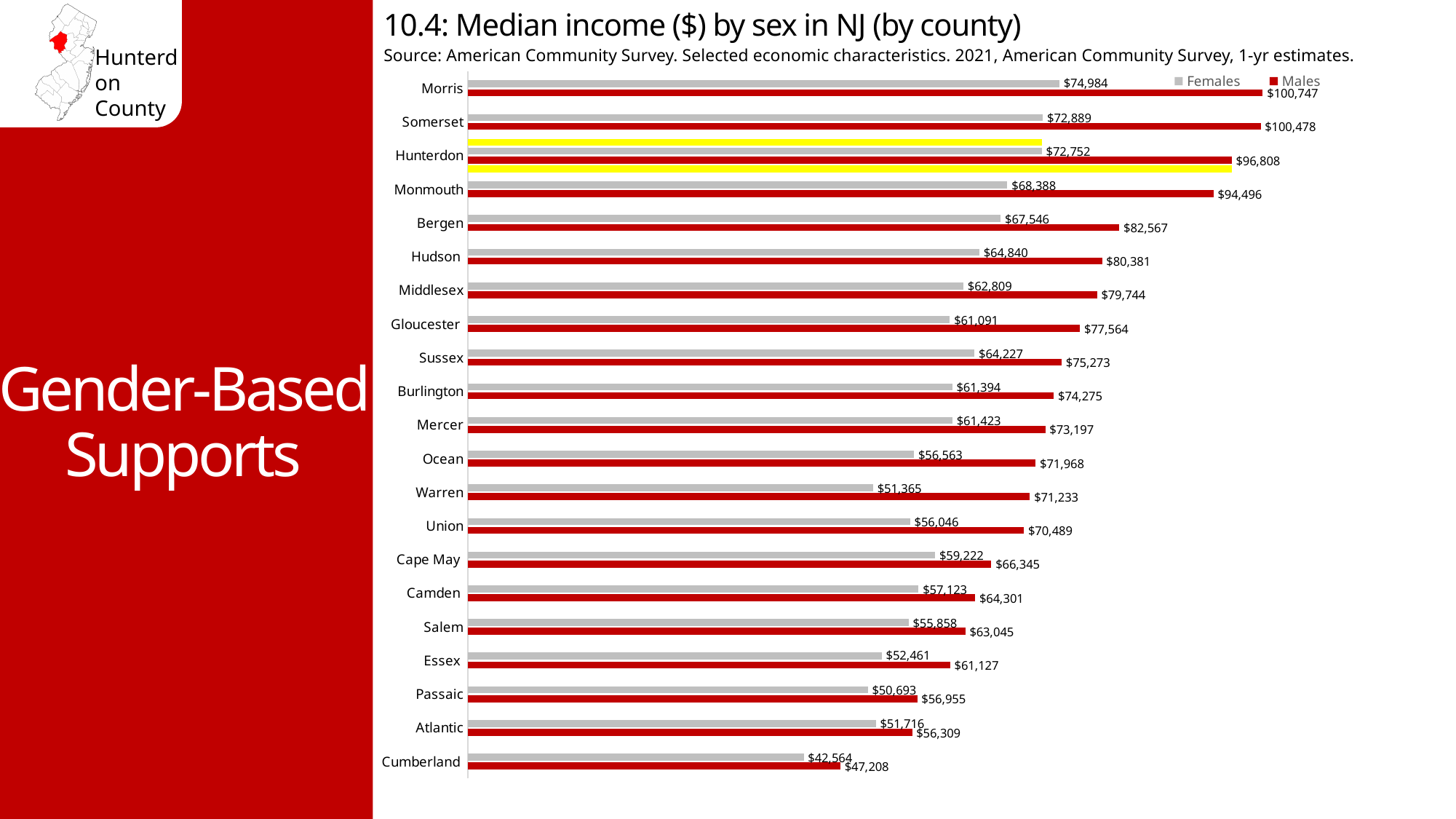
How many series does the legend list? 2 What is the median income for females in Cumberland County? $42,564 What is the difference between the male and female median incomes in Morris County? $25,763 Which county has the lowest median income for females? Cumberland What is the difference between the male and female median incomes in Hunterdon County? $24,056 Which county has the highest median income for males? Morris What is the median income for females in Hunterdon County? $72,752 Which county's bars are highlighted in yellow? Hunterdon Which is larger, the female median income in Sussex County or in Middlesex County? Sussex What is the median income for males in Hunterdon County? $96,808 How many counties are shown in the chart? 21 What kind of chart is shown on the slide? Bar chart